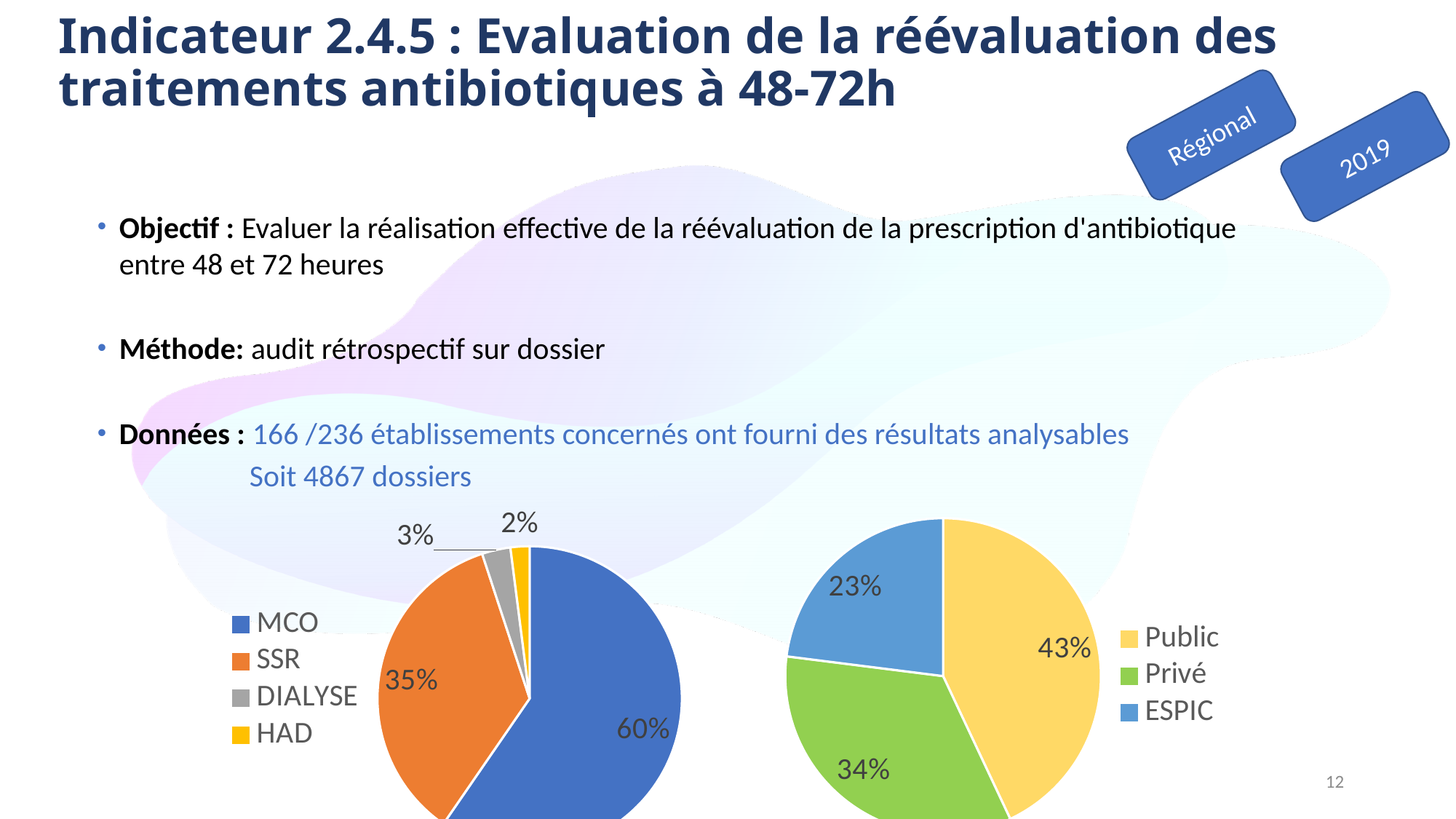
In the left pie chart, what share does DIALYSE have? 3% In the right pie chart, what share does Public have? 43% In the right pie chart, which is larger, Privé or ESPIC? Privé In the left pie chart, what is the difference between the MCO and SSR shares? 25% In the left pie chart, what share does SSR have? 35% In the right pie chart, which category has the smallest share? ESPIC How many categories does the legend of the left pie chart list? 4 In the right pie chart, what share does ESPIC have? 23% In the left pie chart, what share does HAD have? 2% In the left pie chart, which category has the smallest share? HAD In the left pie chart, what share does MCO have? 60% In the left pie chart, which category has the largest share? MCO